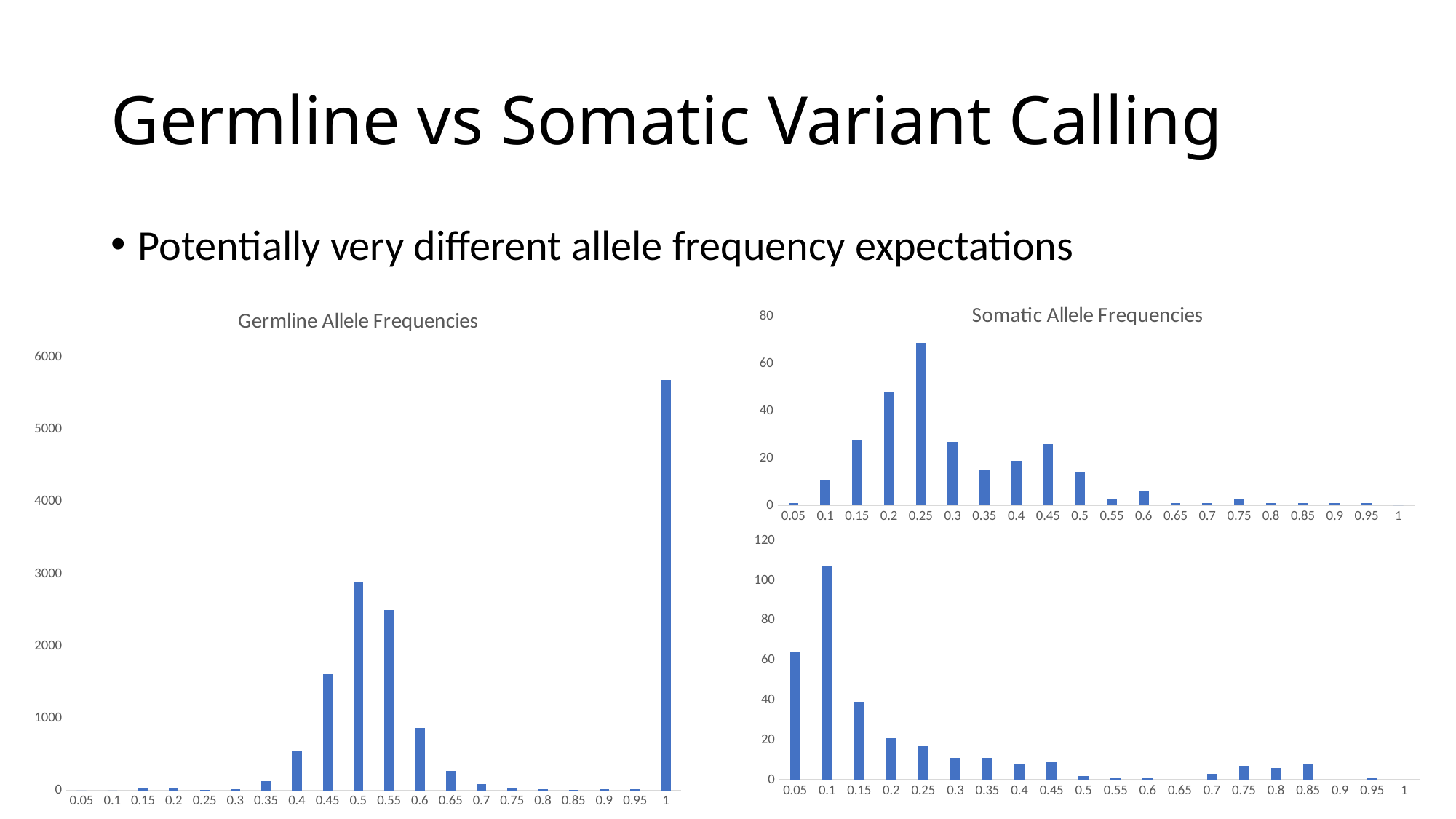
In the Germline Allele Frequencies chart, which is larger, the value for 0.5 or the value for 0.55? 0.5 In the Germline Allele Frequencies chart, is the value for 0.5 greater or less than 2000? greater What kind of chart is the Germline Allele Frequencies chart? bar chart In the bottom-right chart, is the value for 0.1 greater or less than 100? greater In the Germline Allele Frequencies chart, is the value for 1 greater or less than 5000? greater In the Somatic Allele Frequencies chart, which category has the highest bar? 0.25 How many categories are shown on the x axis of the Germline Allele Frequencies chart? 20 In the Germline Allele Frequencies chart, which category has the highest bar? 1 In the bottom-right chart, do the values generally rise or fall from 0.1 to 0.5 along the x axis? fall In the bottom-right chart, which category has the highest bar? 0.1